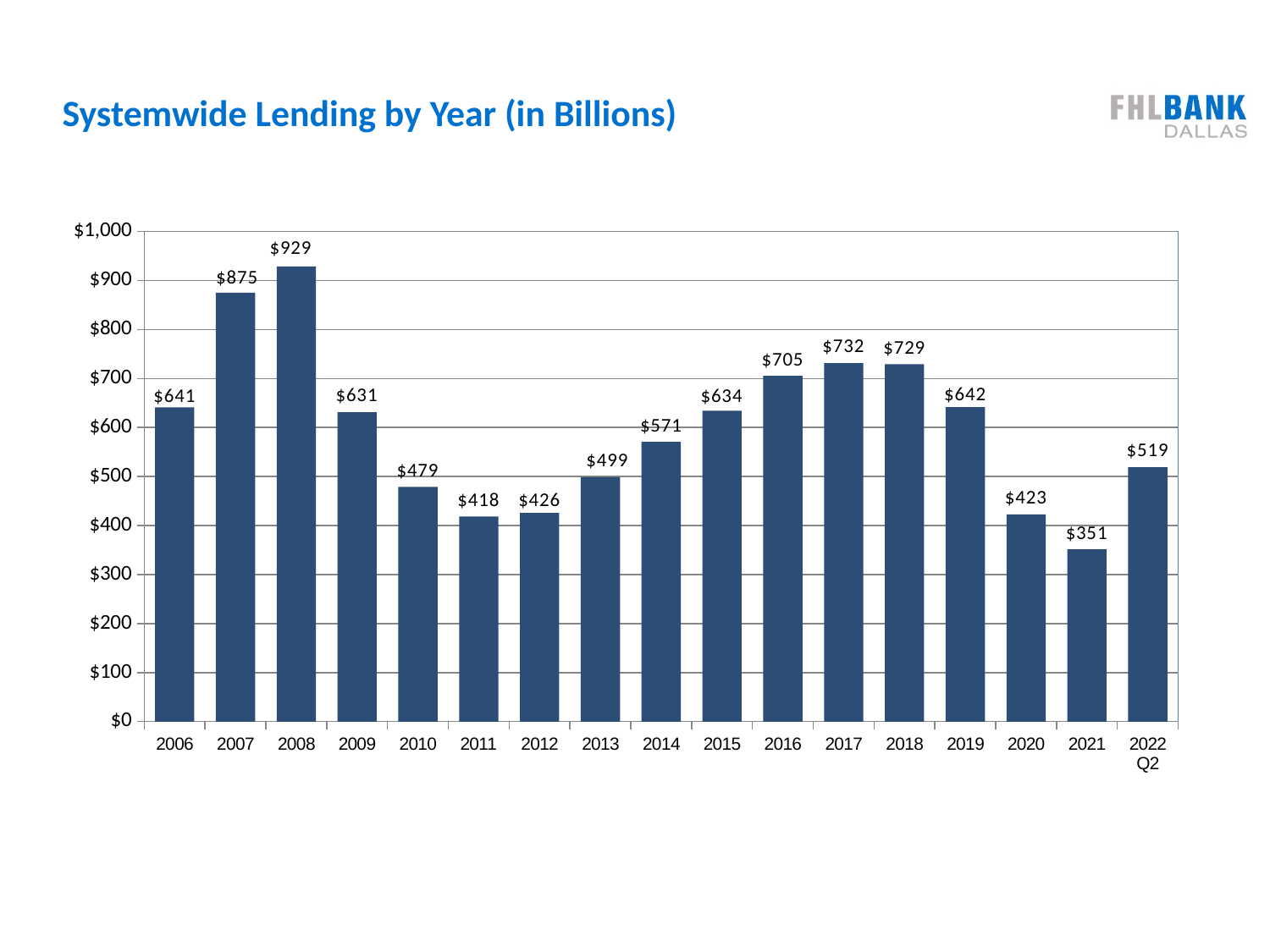
What is the title of the chart? Systemwide Lending by Year (in Billions) What is the systemwide lending value for 2022 Q2? $519 Is the value for 2016 greater or less than $700? greater Do the values rise or fall from 2018 to 2021? Fall What kind of chart is shown on the slide? Bar chart Which is larger, the value for 2017 or the value for 2018? 2017 Which year has the lowest systemwide lending? 2021 What is the systemwide lending value for 2008? $929 Which year has the highest systemwide lending? 2008 What is the systemwide lending value for 2021? $351 What is the difference between the 2008 and 2009 values? $298 How many bars are shown in the chart? 17